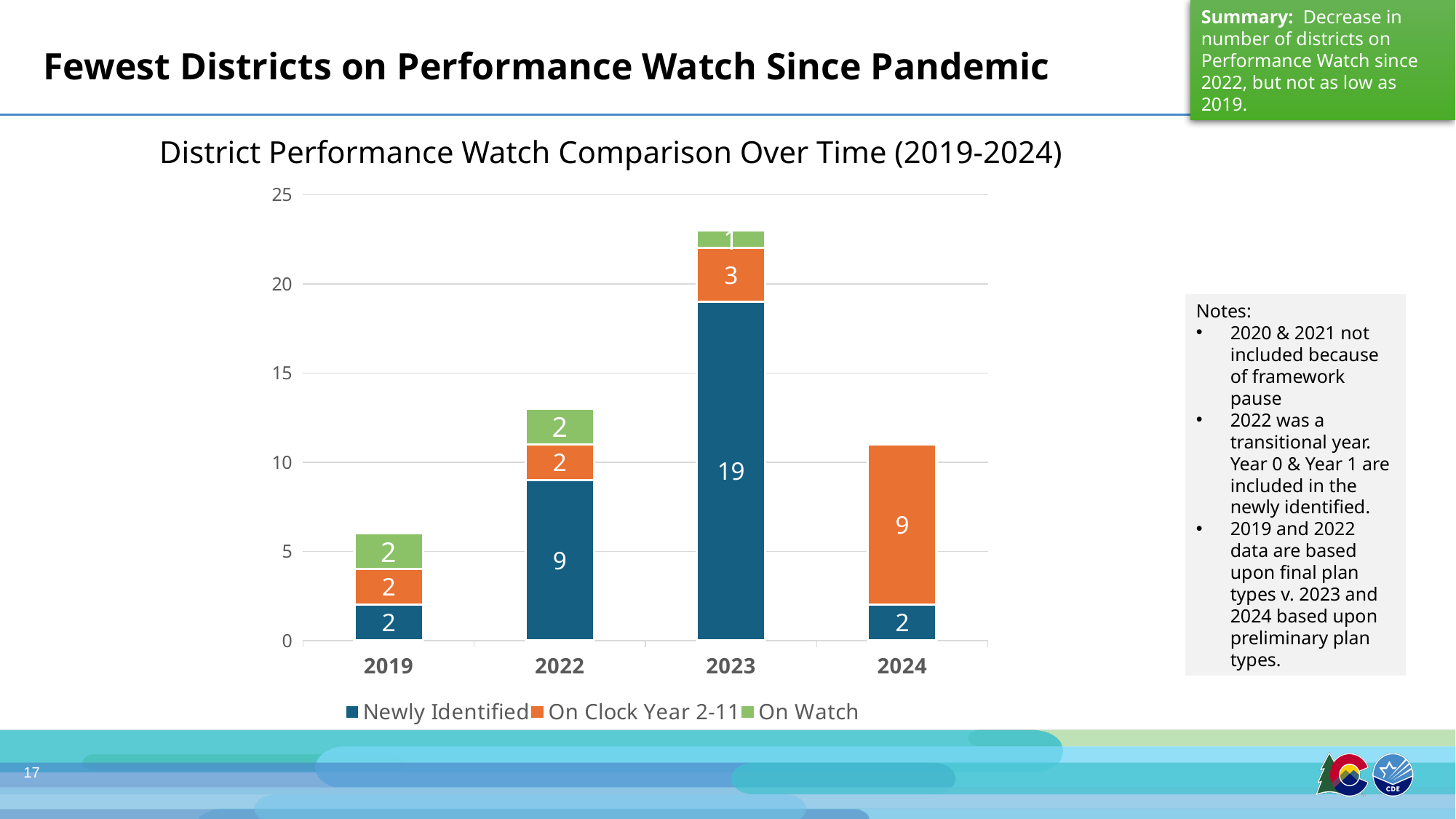
What is the total of the stacked bar for 2019? 6 What is the total of the stacked bar for 2023? 23 What is the difference between the Newly Identified values for 2023 and 2022? 10 What is the Newly Identified value for 2023? 19 What type of chart is shown on the slide? Stacked bar chart Which year has the lowest On Watch value among years with an On Watch segment? 2023 How many series does the legend list? 3 What is the On Clock Year 2-11 value for 2024? 9 Which is larger, the On Clock Year 2-11 value for 2024 or for 2023? 2024 How many years are shown on the x axis? 4 What is the On Watch value for 2022? 2 Which year has the highest Newly Identified value? 2023